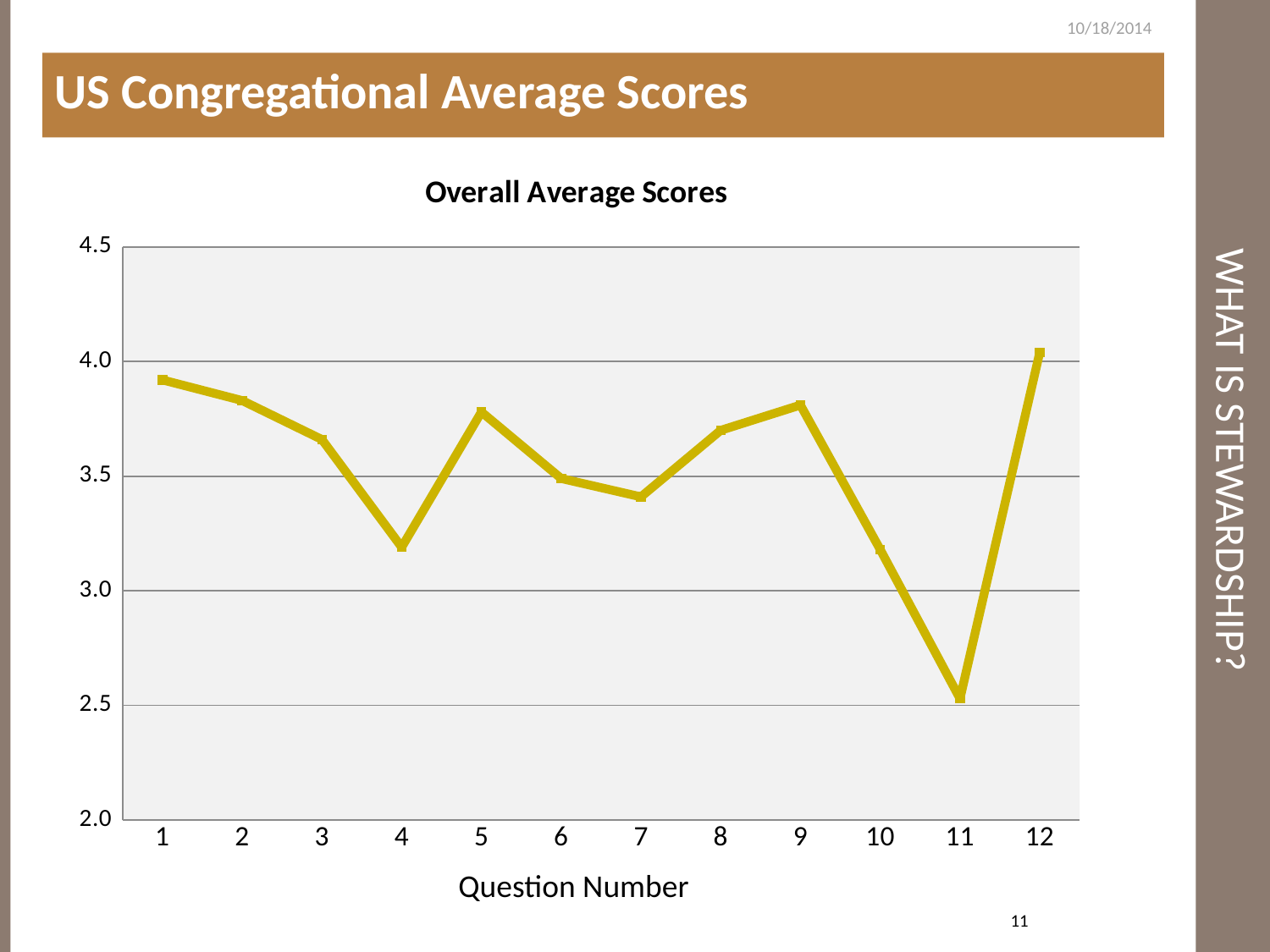
Which has the larger average score, question 9 or question 10? question 9 Do the values rise or fall from question 1 to question 4? fall What is the label of the x axis? Question Number What is the title of the chart? Overall Average Scores How many question numbers are plotted along the x axis? 12 What kind of chart is shown on the slide? line chart Is the value for question 1 greater or less than 3.5? greater Is the value for question 4 greater or less than 3.5? less Which question number has the highest average score? 12 Is the value for question 11 greater or less than 3.0? less Which question number has the lowest average score? 11